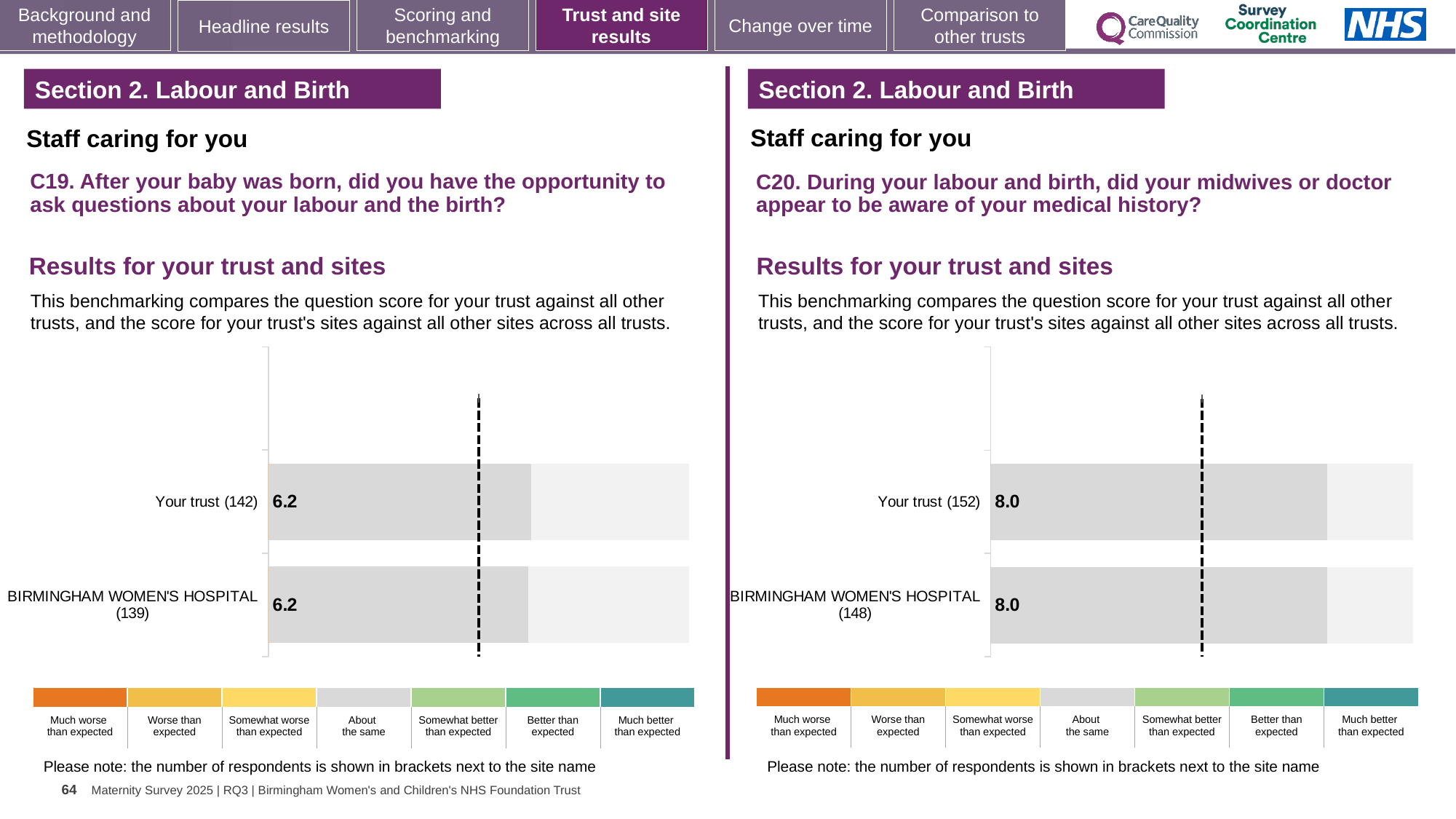
In the C19 chart on the left, what is the difference between the score for Your trust and the score for Birmingham Women's Hospital? 0.0 How many bars are plotted in the C19 chart on the left? 2 In the C20 chart on the right, what is the score for Your trust? 8.0 What kind of chart is used for the C19 results on the left? Bar chart In the C20 chart on the right, how many respondents are shown in brackets for Birmingham Women's Hospital? 148 How many rating categories does the colour key below the C20 chart on the right list? 7 In the C20 chart on the right, what is the score for Birmingham Women's Hospital? 8.0 In the C19 chart on the left, how many respondents are shown in brackets for Your trust? 142 How many bars are plotted in the C20 chart on the right? 2 In the C19 chart on the left, what is the score for Birmingham Women's Hospital? 6.2 In the C19 chart on the left, what is the score for Your trust? 6.2 In the colour key below the C19 chart on the left, which category is shown in grey? About the same